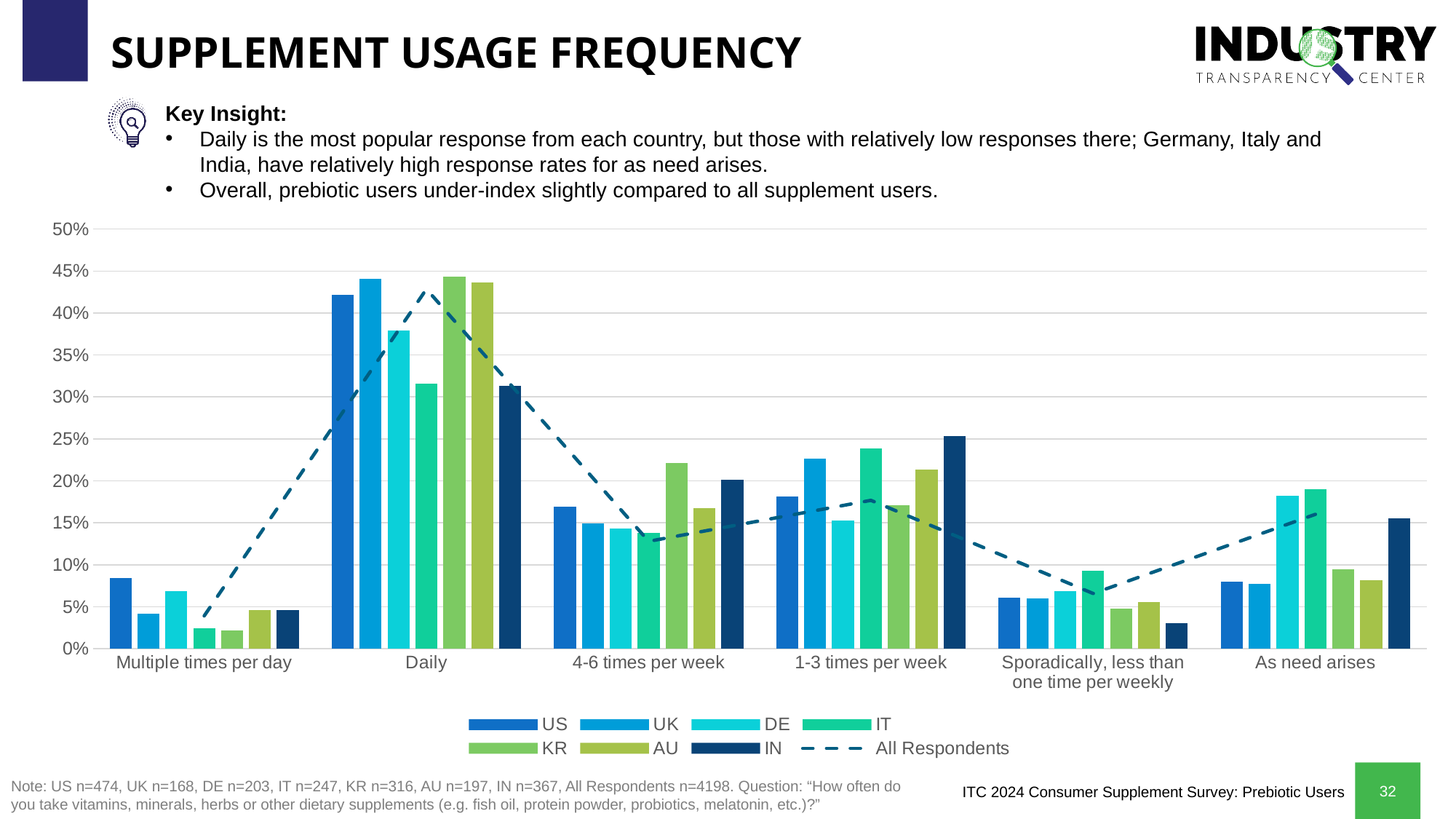
What kind of chart is shown on the slide? combination bar and line chart Which country has the highest value in the 1-3 times per week category? IN How many series does the legend list? 8 Which category has the highest value for US? Daily Is the value for IT in the Sporadically, less than one time per weekly category greater or less than 5%? greater How many usage-frequency categories are shown on the x axis? 6 Is the value for KR in the Daily category greater or less than 35%? greater Which country has the lowest value in the Sporadically, less than one time per weekly category? IN How is the All Respondents series drawn on the chart? as a dashed line Is the value for US in the Daily category greater or less than 40%? greater In the 4-6 times per week category, which is larger, the value for KR or the value for US? KR